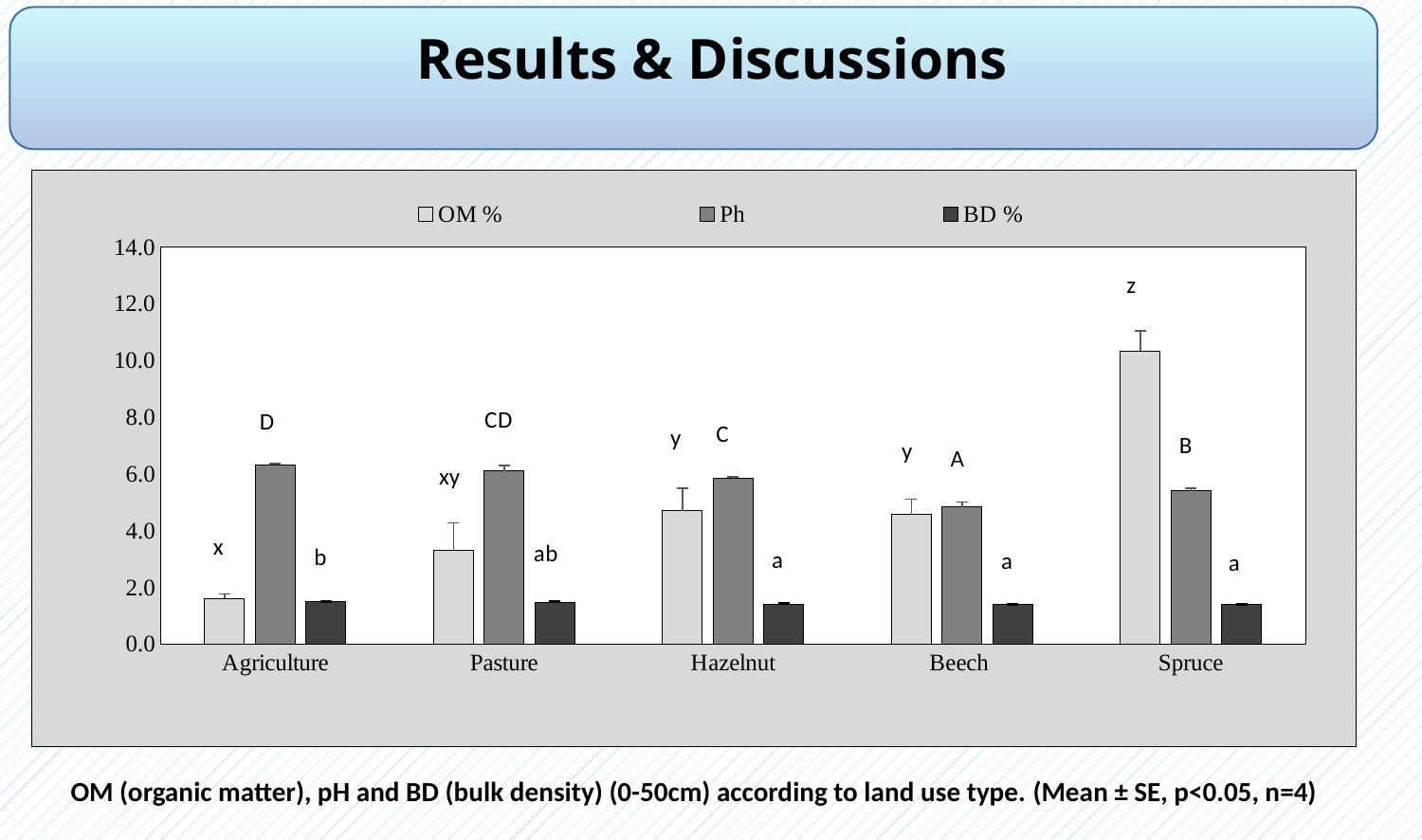
Which land use type has the lowest OM % value? Agriculture Is the OM % value for Spruce greater or less than 8.0? greater Is the BD % value for Agriculture greater or less than 2.0? less Which land use type has the lowest Ph value? Beech Which is larger for Spruce, the OM % value or the Ph value? OM % How many land use types are shown on the x axis? 5 Which land use type has the highest OM % value? Spruce What letter is printed above the OM % bar for Spruce? z Which is larger for Hazelnut, the OM % value or the Ph value? Ph What kind of chart is shown on the slide? bar chart Is the Ph value for Agriculture greater or less than 4.0? greater How many series does the legend list? 3